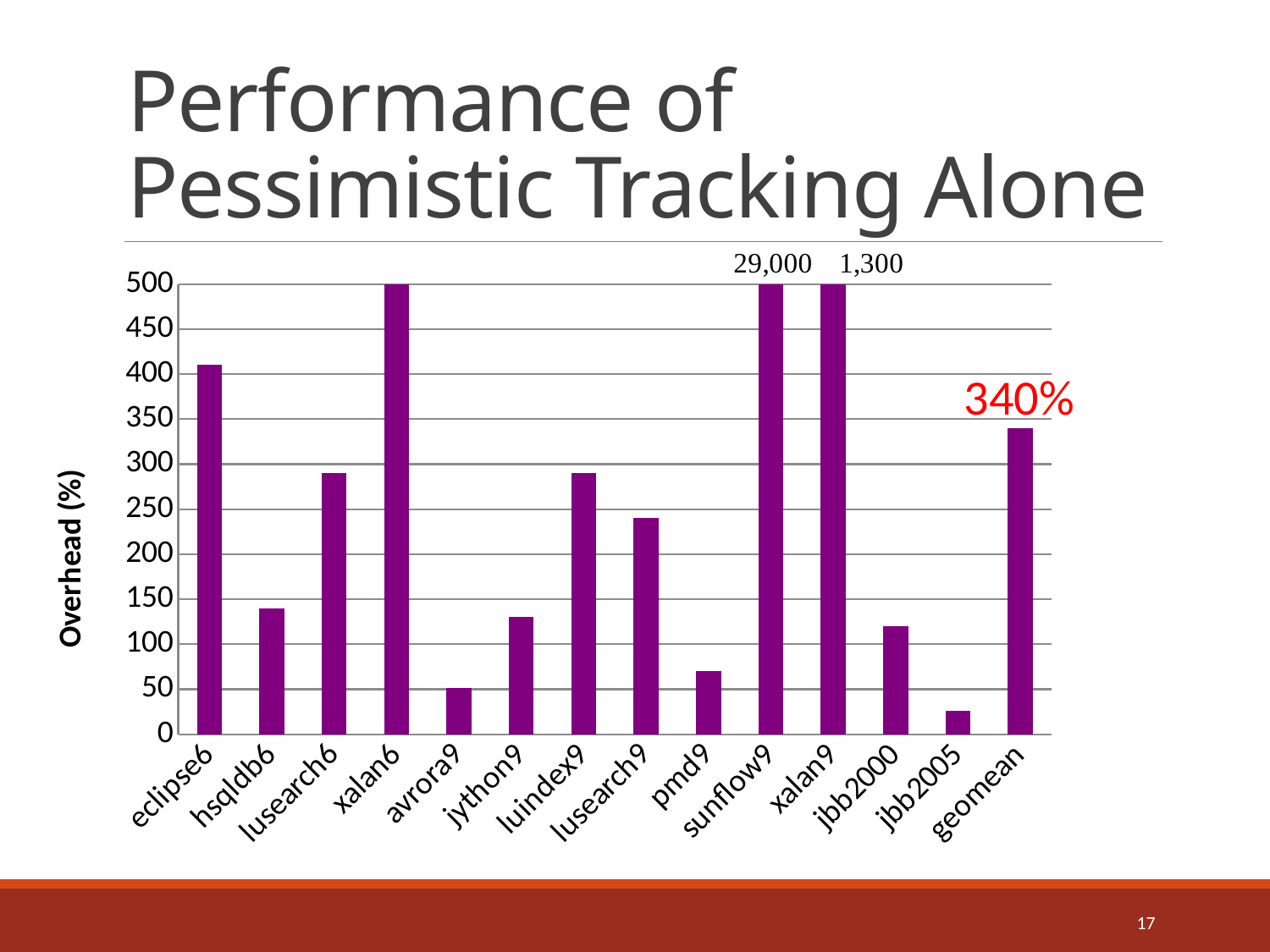
Is the overhead for avrora9 greater or less than 100? less How many benchmark categories are shown on the x axis of the chart? 14 Which benchmark has the highest overhead in the chart? sunflow9 Which benchmark has the lowest overhead in the chart? jbb2005 Which has the larger overhead, lusearch9 or pmd9? lusearch9 What kind of chart is shown on the slide? bar chart Is the overhead for eclipse6 greater or less than 350? greater What value is printed above the sunflow9 bar? 29,000 What is the label on the vertical axis of the chart? Overhead (%) What is the title of the chart on the slide? Performance of Pessimistic Tracking Alone What value is printed above the xalan9 bar? 1,300 What overhead value is printed for geomean? 340%